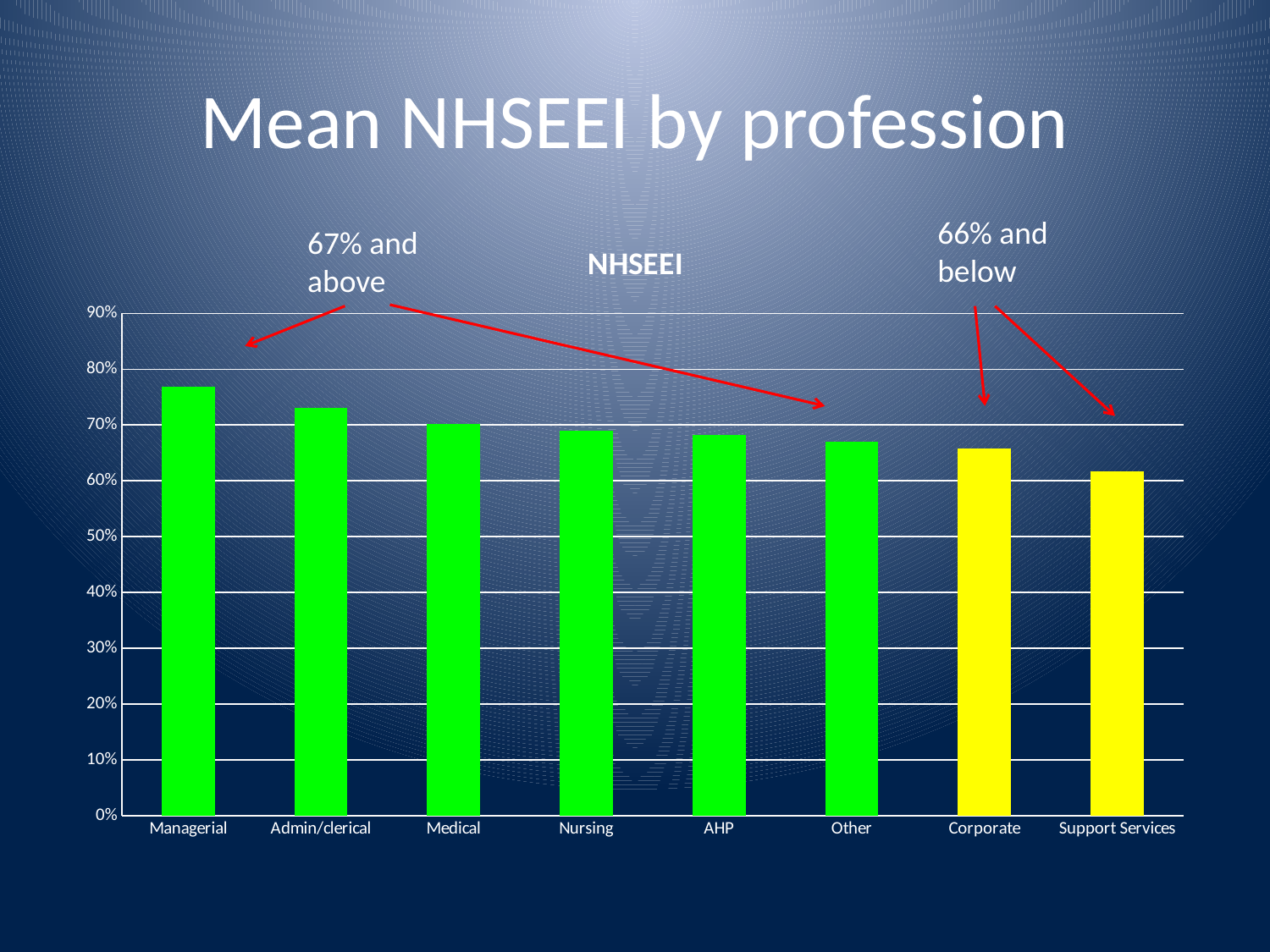
Which professions are shown with yellow bars? Corporate and Support Services Do the bar values rise or fall from left to right along the x axis? Fall How many professions are shown on the x axis of the chart? 8 Which is larger, the value for Managerial or the value for Support Services? Managerial Is the value for Corporate greater or less than 70%? less Which profession has the lowest mean NHSEEI? Support Services Which profession has the highest mean NHSEEI? Managerial Is the value for Managerial greater or less than 70%? greater Is the value for Admin/clerical greater or less than 80%? less Which is larger, the value for Admin/clerical or the value for Corporate? Admin/clerical What kind of chart is shown on the slide? Bar chart